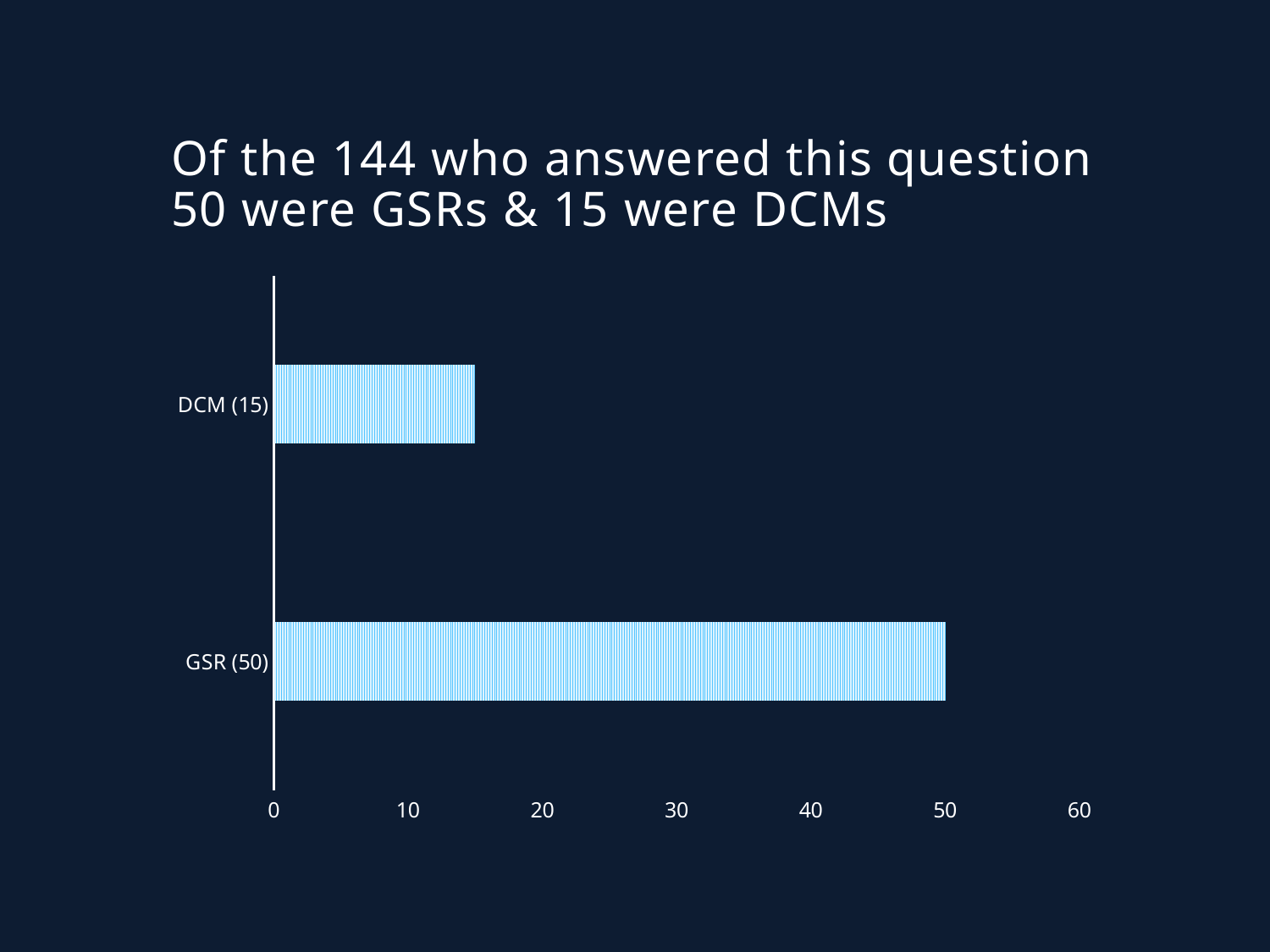
What is the difference between the GSR value and the DCM value? 35 Is the value for DCM greater or less than 20? less What is the highest tick value shown on the horizontal axis? 60 Is the value for GSR greater or less than 40? greater What is the value for DCM? 15 Which category has the lowest value? DCM Which category has the highest value? GSR According to the slide title, how many people answered this question? 144 Which is larger, the value for GSR or the value for DCM? GSR How many categories are shown in the chart? 2 What kind of chart is shown on the slide? bar chart What is the value for GSR? 50